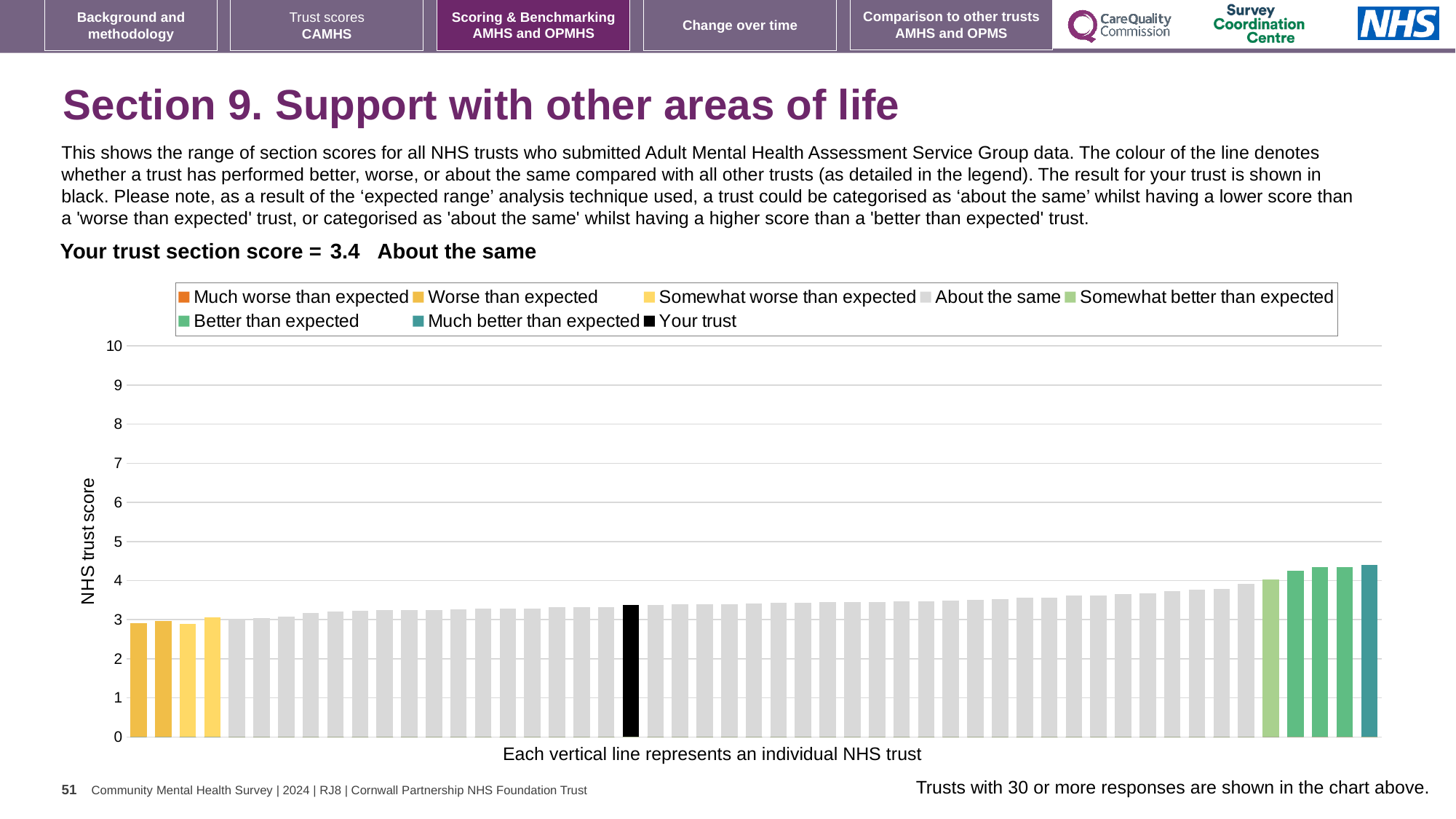
Is the value of the tallest bar in the chart greater or less than 4? greater What is the section score for your trust shown on the slide? 3.4 Is the value of the shortest bar in the chart greater or less than 3? less Is the value of the tallest bar in the chart greater or less than 5? less What is the label on the vertical axis of the chart? NHS trust score What kind of chart is shown on the slide? Bar chart Do the bar values rise or fall from left to right along the x axis? rise What colour is the bar representing your trust in the chart? Black Which category does your trust's section score fall into, according to the slide? About the same How many entries does the chart legend list? 8